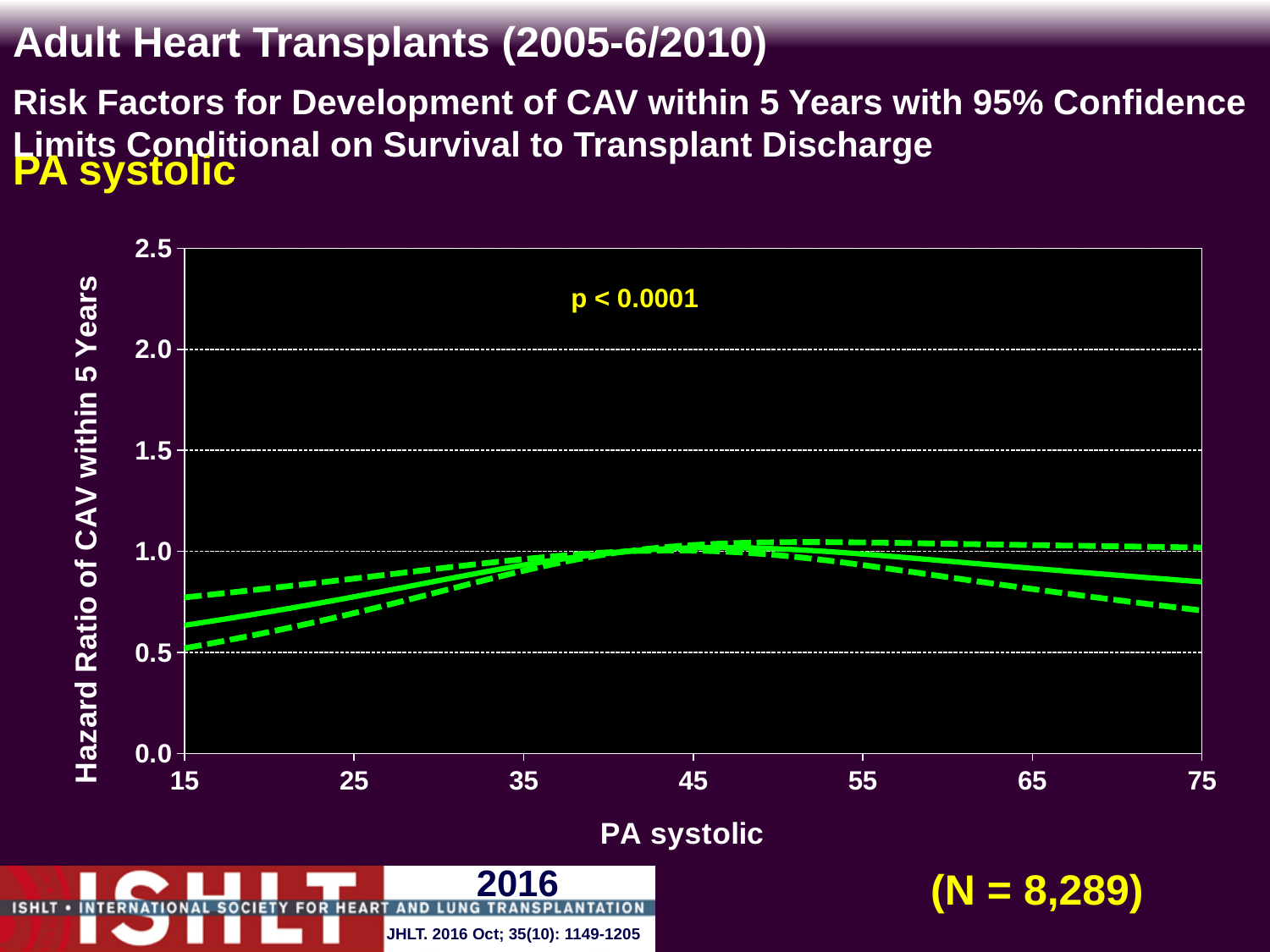
What is the label of the x axis of the chart? PA systolic Is the hazard ratio (solid line) at a PA systolic of 15 greater or less than 0.5? greater How many lines are plotted on the chart? 3 What p-value is printed on the chart? p < 0.0001 Does the hazard ratio (solid line) rise or fall as PA systolic increases from 45 to 75? fall Is the upper confidence limit (upper dashed line) at a PA systolic of 15 greater or less than 1.0? less Does the hazard ratio (solid line) rise or fall as PA systolic increases from 15 to 45? rise What is the label of the y axis of the chart? Hazard Ratio of CAV within 5 Years Is the hazard ratio (solid line) at a PA systolic of 75 greater or less than 1.0? less What sample size (N) is shown on the slide? N = 8,289 What kind of chart is shown on the slide? line chart